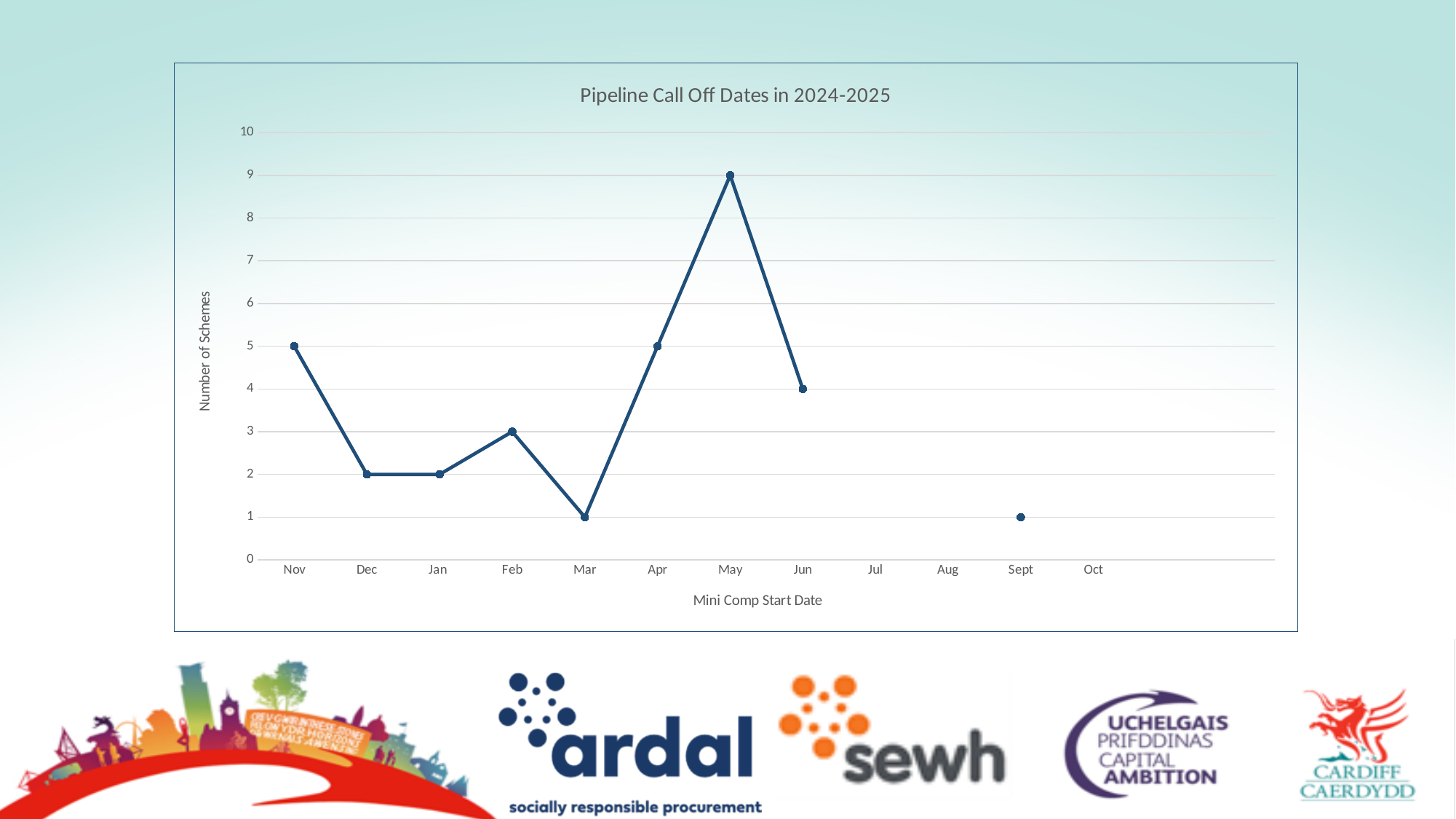
Do the values rise or fall from Mar to May? Rise Is the value for Jun greater or less than 5? less What kind of chart is shown on the slide? Line chart Which month has the highest number of schemes? May What is the label of the x axis? Mini Comp Start Date What is the number of schemes for Nov? 5 What is the number of schemes for May? 9 Which has more schemes, Feb or Mar? Feb What is the difference in number of schemes between May and Apr? 4 How many months are labelled on the x axis? 12 What is the number of schemes for Jun? 4 What is the title of the chart? Pipeline Call Off Dates in 2024-2025